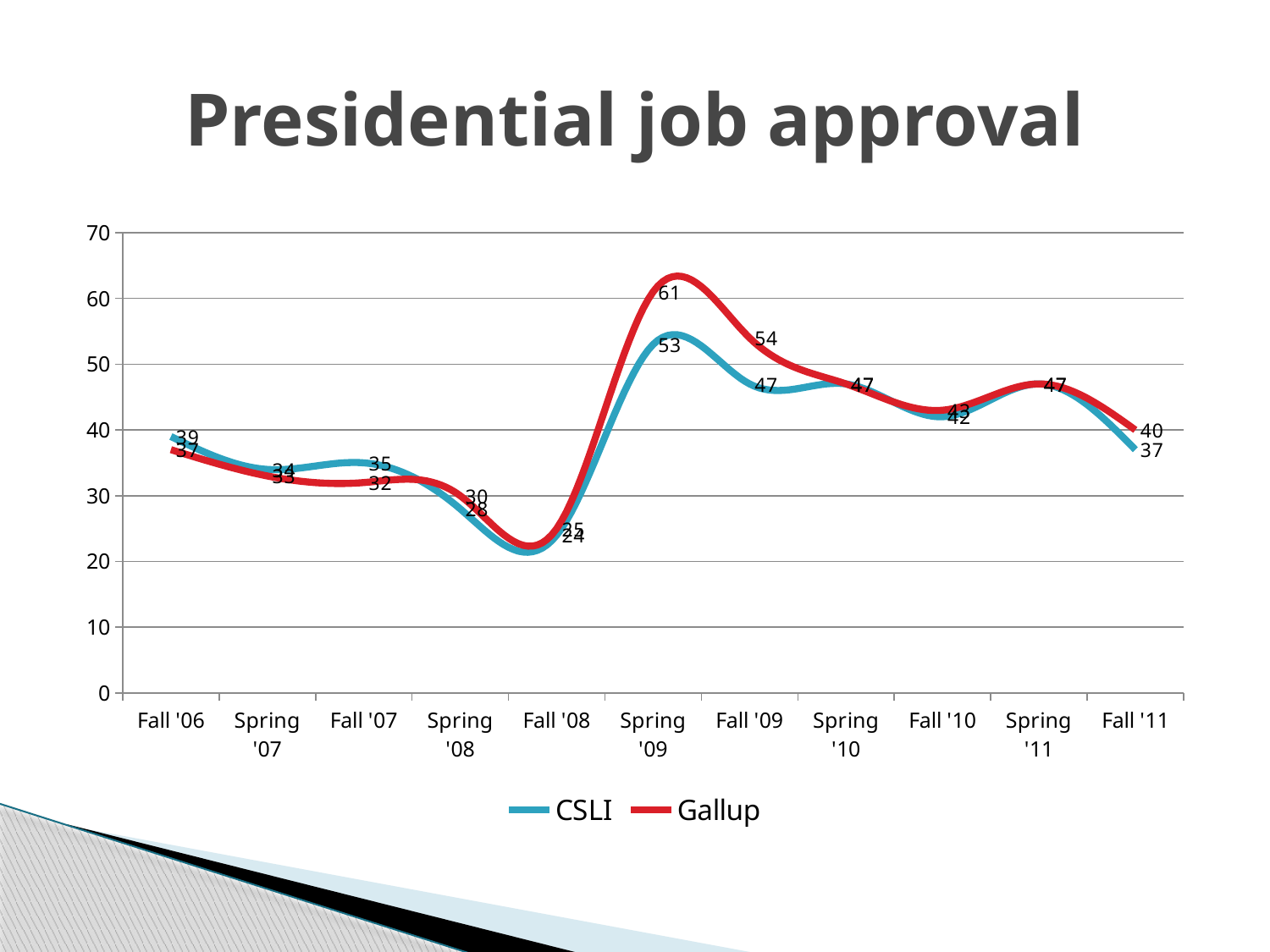
Which colour is used for the Gallup series? red What is the Gallup value for Spring '09? 61 What is the CSLI value for Spring '09? 53 What is the Gallup value for Fall '11? 40 Is the CSLI value for Fall '08 greater or less than 30? less What is the CSLI value for Fall '06? 39 How many time points are plotted along the x axis? 11 Which series has the larger value at Fall '09, CSLI or Gallup? Gallup What is the difference between the Gallup and CSLI values for Spring '09? 8 At which time point does the Gallup series reach its highest value? Spring '09 How many series does the legend list? 2 What kind of chart is shown on the slide? line chart